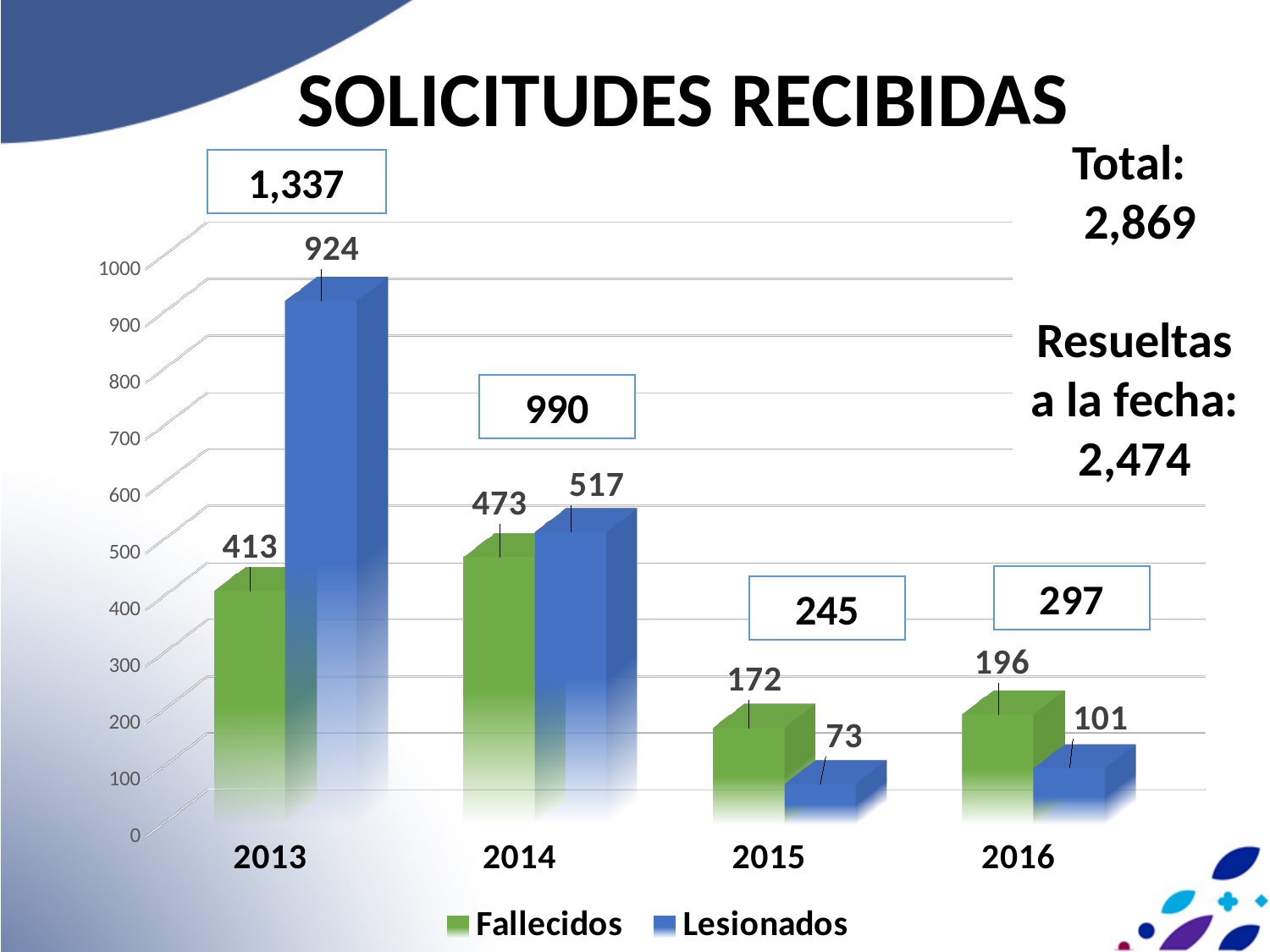
What is the value for Fallecidos in 2013? 413 How many years are shown on the x axis? 4 What is the value for Lesionados in 2015? 73 What is the title of the chart? SOLICITUDES RECIBIDAS How many series does the legend list? 2 What is the difference between Lesionados and Fallecidos in 2013? 511 Which is larger in 2016, Fallecidos or Lesionados? Fallecidos What is the value for Lesionados in 2014? 517 Which year has the lowest value for Fallecidos? 2015 Do the Lesionados values rise or fall from 2013 to 2015? Fall What kind of chart is shown on the slide? Bar chart Which year has the highest value for Lesionados? 2013